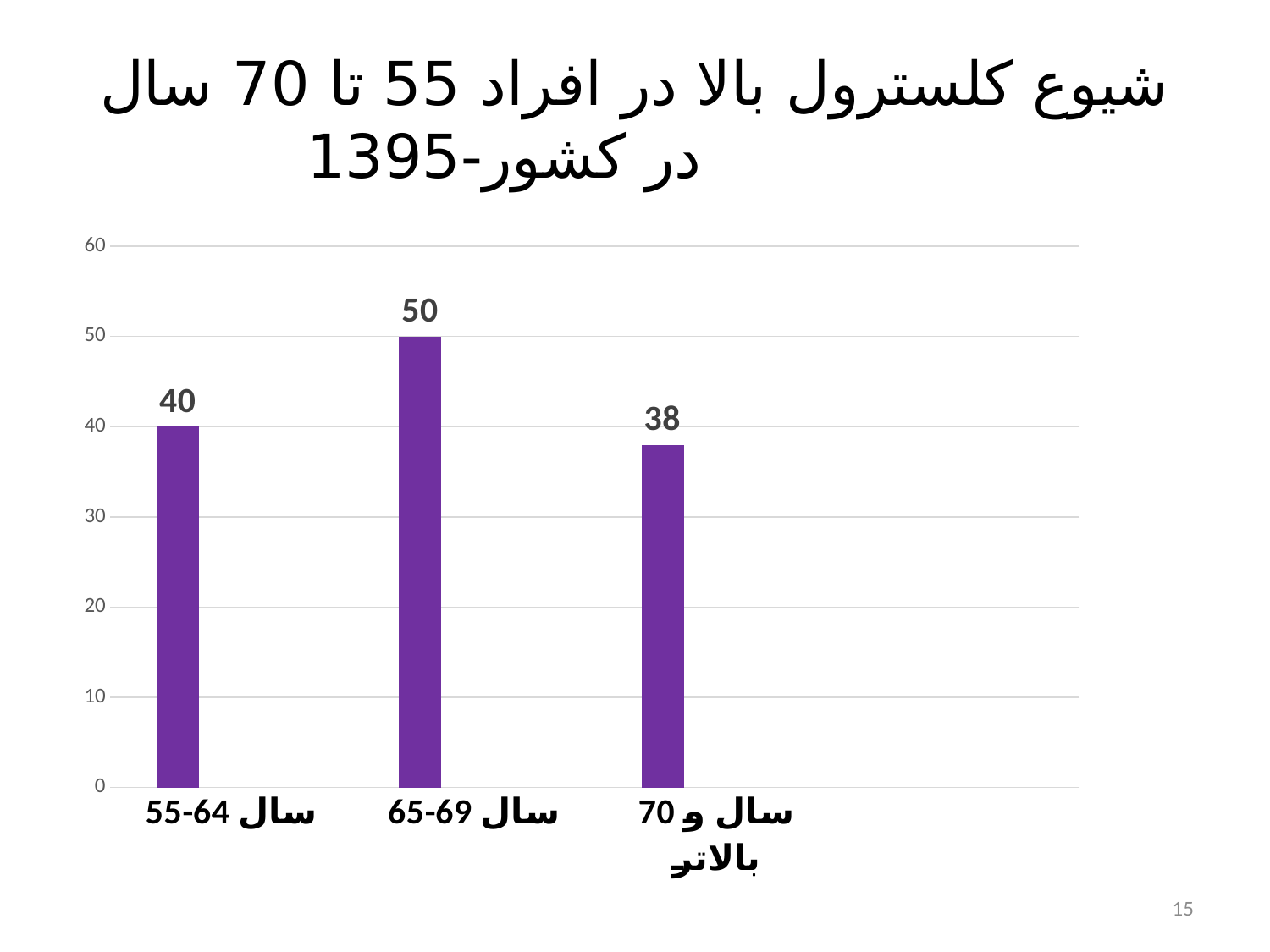
Which is larger, the value for 65-69 سال or the value for 70 سال و بالاتر? 65-69 سال What is the value for the 70 سال و بالاتر category? 38 What is the value for the 65-69 سال category? 50 What is the value for the 55-64 سال category? 40 What kind of chart is shown on the slide? bar chart What is the difference between the values for 55-64 سال and 70 سال و بالاتر? 2 What is the maximum value shown on the vertical axis? 60 How many age categories are shown in the chart? 3 Is the value for 70 سال و بالاتر greater or less than 40? less What is the difference between the values for 65-69 سال and 55-64 سال? 10 Which age category has the highest value? 65-69 سال Which age category has the lowest value? 70 سال و بالاتر